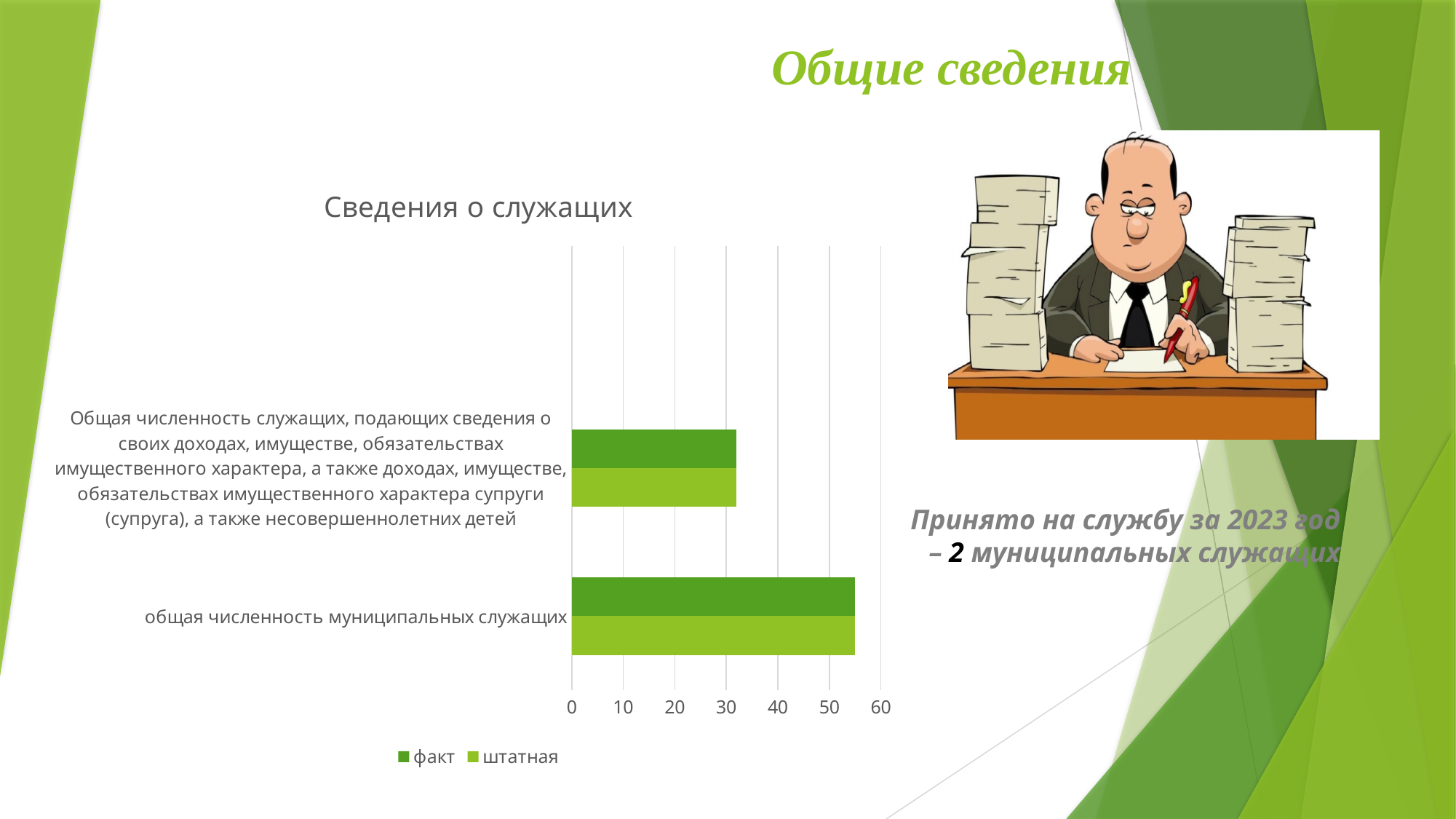
How many series does the chart legend list? 2 Which category has the highest value for the series 'факт'? общая численность муниципальных служащих Is the 'штатная' value for 'общая численность муниципальных служащих' greater or less than 60? less Is the 'факт' value for the category about employees submitting income information greater or less than 40? less Is the 'факт' value for 'общая численность муниципальных служащих' greater or less than 50? greater Which is larger for the series 'факт': the value for 'общая численность муниципальных служащих' or the value for the category about employees submitting income information? общая численность муниципальных служащих What kind of chart is shown on the slide? bar chart How many categories are shown on the chart? 2 What are the series names listed in the chart legend? факт, штатная What is the title of the chart? Сведения о служащих